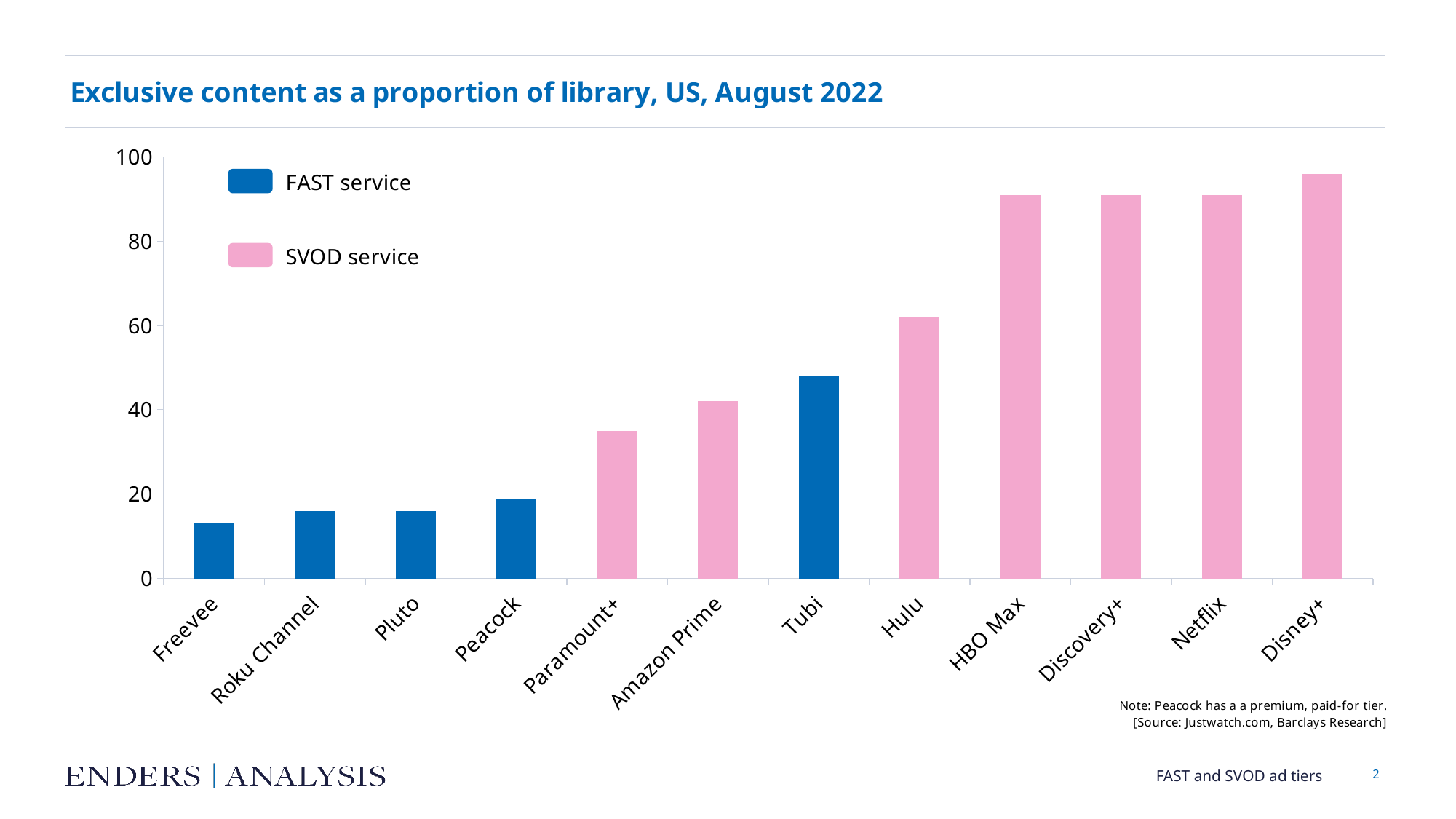
How many series does the legend list? 2 Which service has the lowest proportion of exclusive content? Freevee How many services are shown on the x axis of the chart? 12 Which service has the highest proportion of exclusive content? Disney+ Is the value for Paramount+ greater or less than 40? less What kind of chart is shown on the slide? bar chart Do the values generally rise or fall moving from left to right along the x axis? rise Which legend entry is shown in pink? SVOD service Which has a higher proportion of exclusive content, Tubi or Hulu? Hulu Which has a higher proportion of exclusive content, Peacock or Paramount+? Paramount+